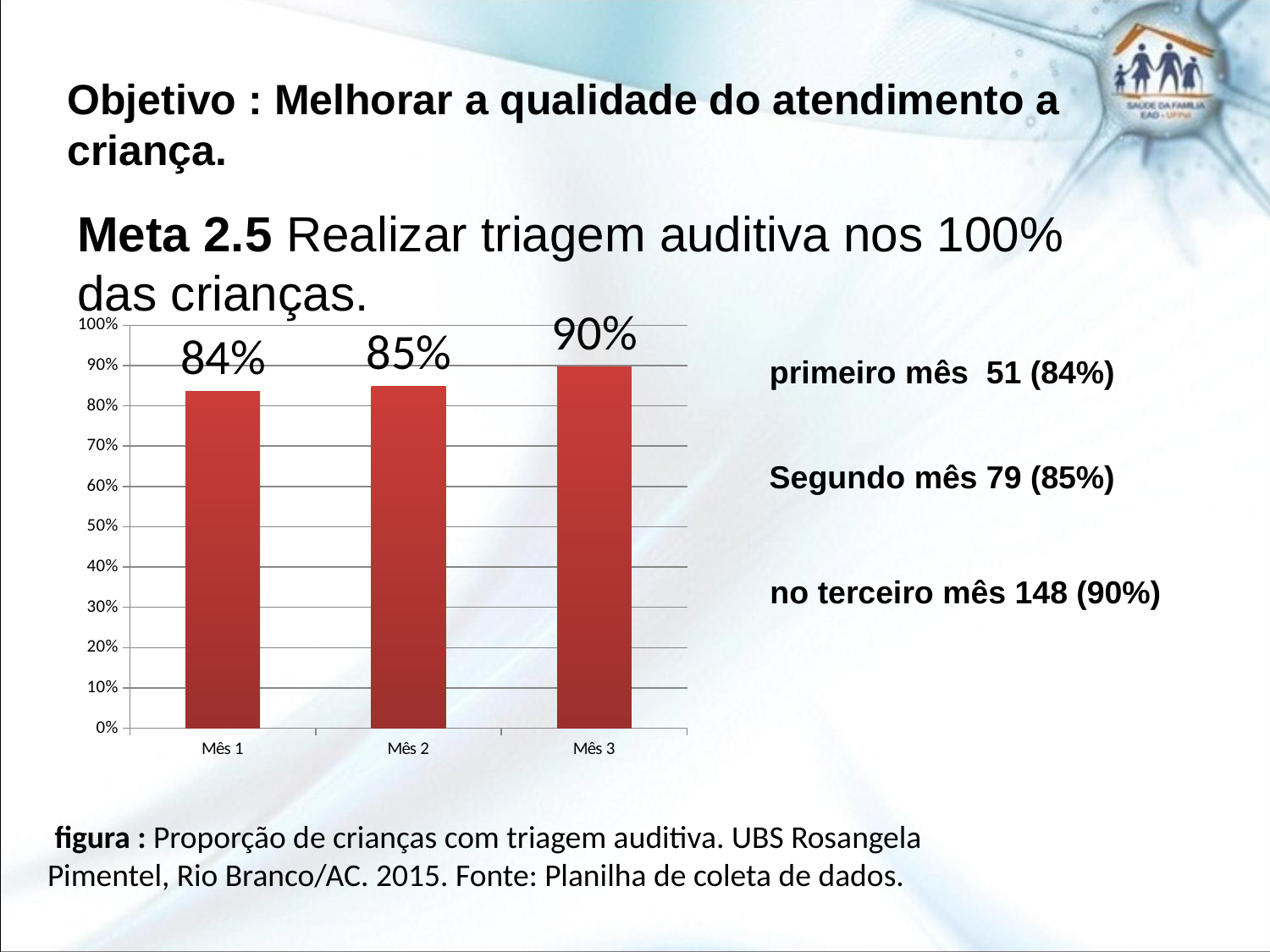
Do the values rise or fall from Mês 1 to Mês 3? rise Is the value for Mês 1 greater or less than 80%? greater Which is larger, the value for Mês 3 or the value for Mês 2? Mês 3 What is the difference between the values for Mês 2 and Mês 1? 1% What is the difference between the values for Mês 3 and Mês 1? 6% What is the value for Mês 1? 84% How many months are shown on the x axis? 3 What is the value for Mês 3? 90% Which month has the lowest value? Mês 1 Which month has the highest value? Mês 3 What kind of chart is shown on the slide? bar chart What is the value for Mês 2? 85%